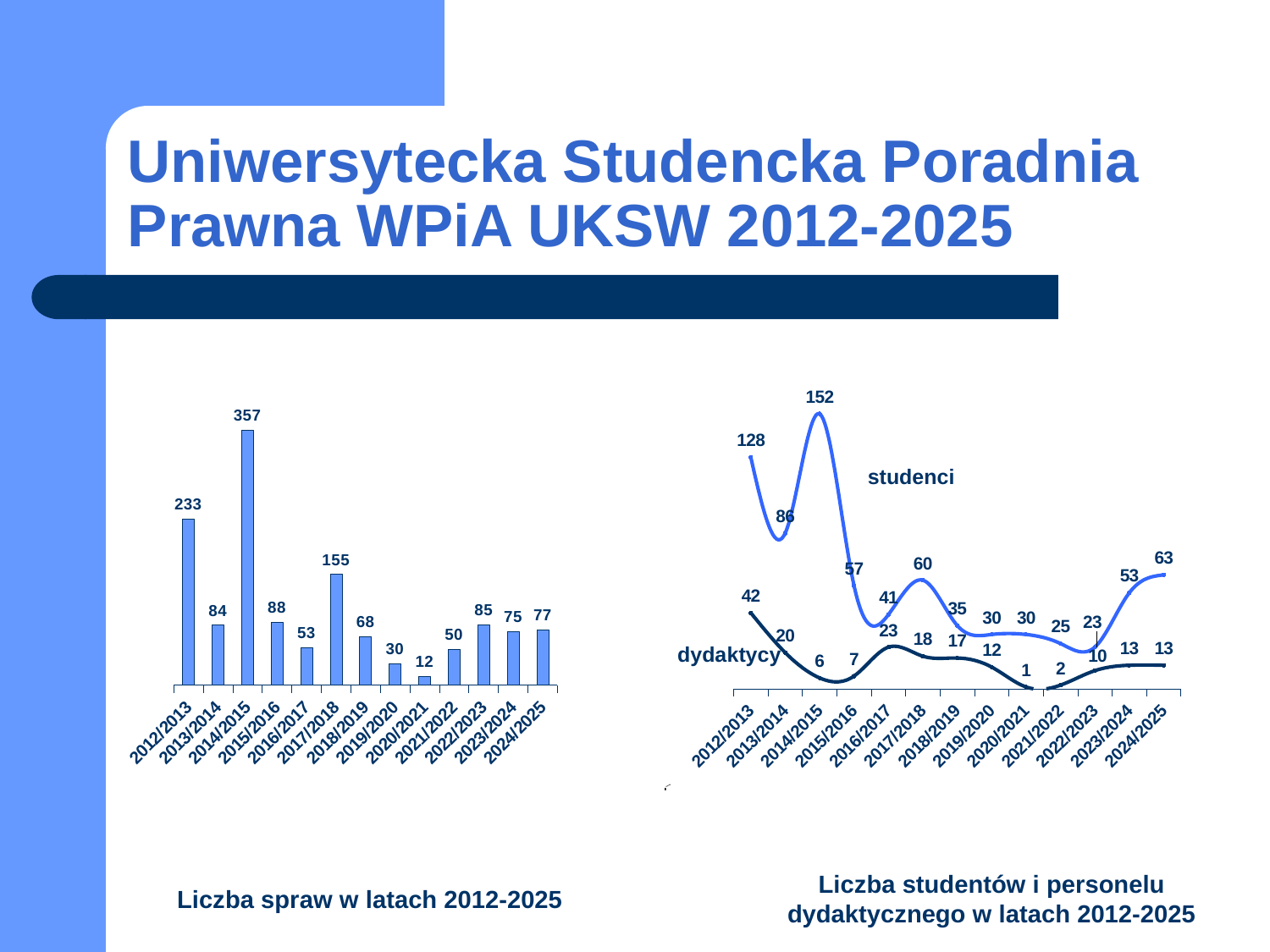
In the chart 'Liczba spraw w latach 2012-2025', what is the value for 2014/2015? 357 In the chart 'Liczba studentów i personelu dydaktycznego w latach 2012-2025', what is the difference between studenci and dydaktycy in 2012/2013? 86 How many series are plotted in the chart 'Liczba studentów i personelu dydaktycznego w latach 2012-2025'? 2 In the chart 'Liczba spraw w latach 2012-2025', which year has the highest value? 2014/2015 In the chart 'Liczba spraw w latach 2012-2025', which year has the lowest value? 2020/2021 In the chart 'Liczba spraw w latach 2012-2025', what is the difference between the values for 2012/2013 and 2013/2014? 149 In the chart 'Liczba studentów i personelu dydaktycznego w latach 2012-2025', which series has the higher value in 2024/2025, studenci or dydaktycy? studenci In the chart 'Liczba studentów i personelu dydaktycznego w latach 2012-2025', what is the value for dydaktycy in 2020/2021? 1 What kind of chart is 'Liczba studentów i personelu dydaktycznego w latach 2012-2025'? line chart In the chart 'Liczba spraw w latach 2012-2025', how many years are shown on the x axis? 13 In the chart 'Liczba studentów i personelu dydaktycznego w latach 2012-2025', what is the value for studenci in 2014/2015? 152 What kind of chart is 'Liczba spraw w latach 2012-2025'? bar chart